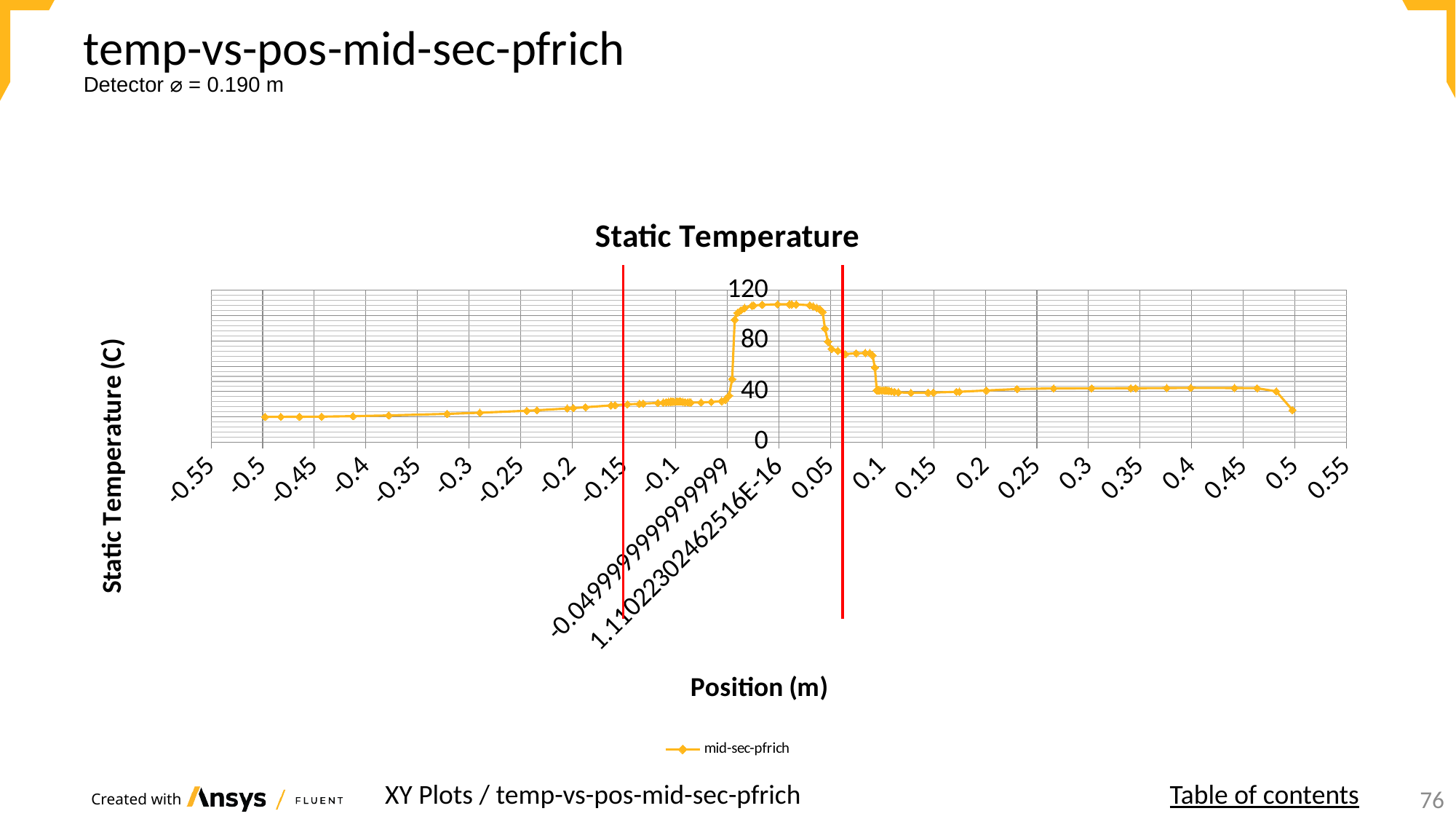
What is the name of the series shown in the legend of the chart? mid-sec-pfrich Is the value for mid-sec-pfrich at position 0.1 greater or less than 80? less Is the value for mid-sec-pfrich at position 0 greater or less than 80? greater What is the title of the chart on the slide? Static Temperature Is the value for mid-sec-pfrich at position 0.5 greater or less than 40? less What kind of chart is shown on the slide? line chart How many series does the legend of the Static Temperature chart list? 1 Do the values of mid-sec-pfrich rise or fall along the x axis from position -0.5 to -0.15? rise